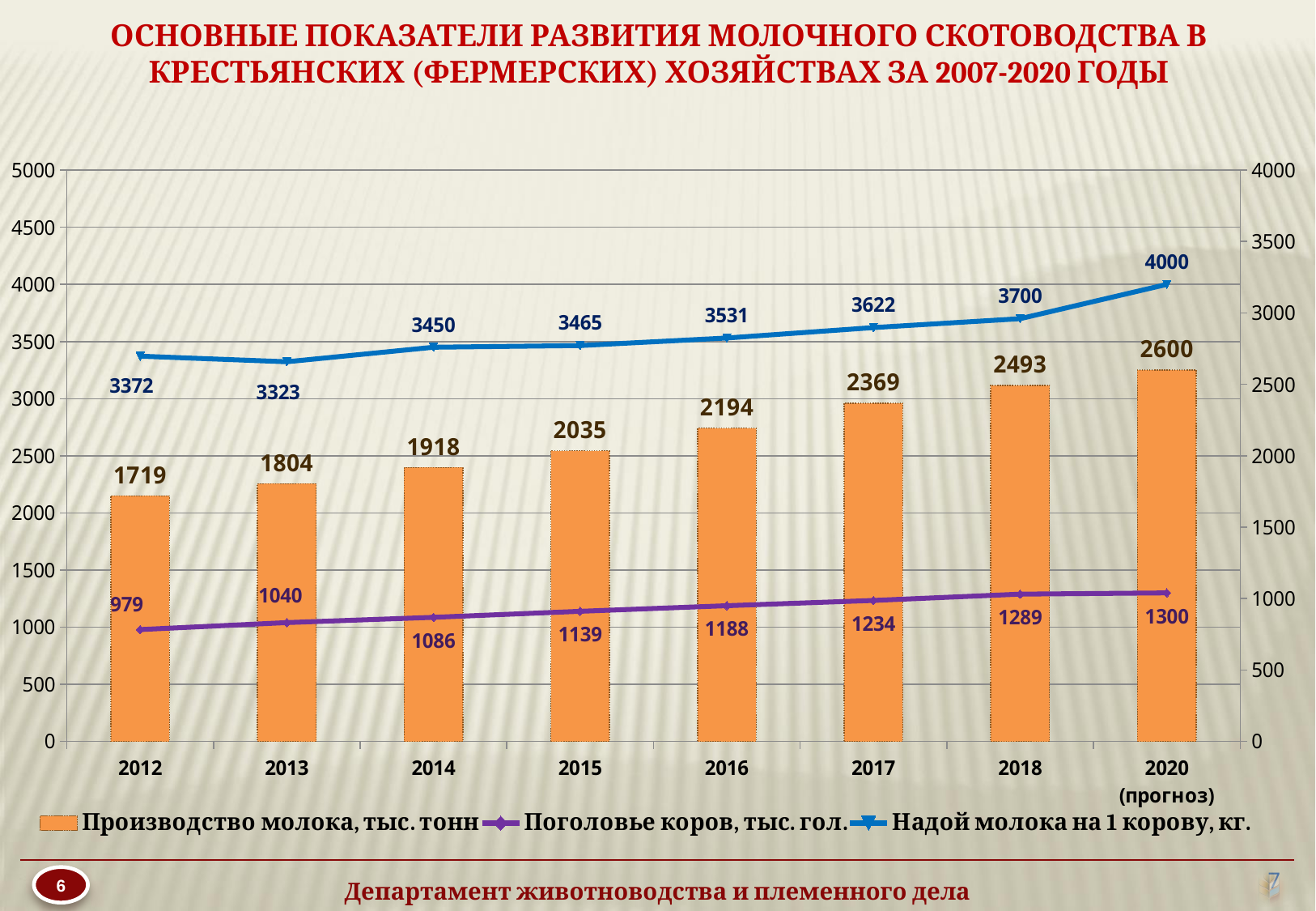
What is the value of Производство молока, тыс. тонн for 2016? 2194 What is the value of Поголовье коров, тыс. гол. for 2014? 1086 In which year is Производство молока, тыс. тонн the highest? 2020 (прогноз) What is the value of Надой молока на 1 корову, кг. for 2018? 3700 Does Производство молока, тыс. тонн rise or fall from 2012 to 2020? Rise What is the difference between Надой молока на 1 корову, кг. in 2020 (прогноз) and in 2012? 628 In which year is Надой молока на 1 корову, кг. the lowest? 2013 How many series does the legend list? 3 Which is larger: Поголовье коров, тыс. гол. in 2015 or in 2016? 2016 What is the difference between Производство молока, тыс. тонн in 2018 and in 2017? 124 How many years are shown on the x axis? 8 What kind of chart is this? Combined bar and line chart